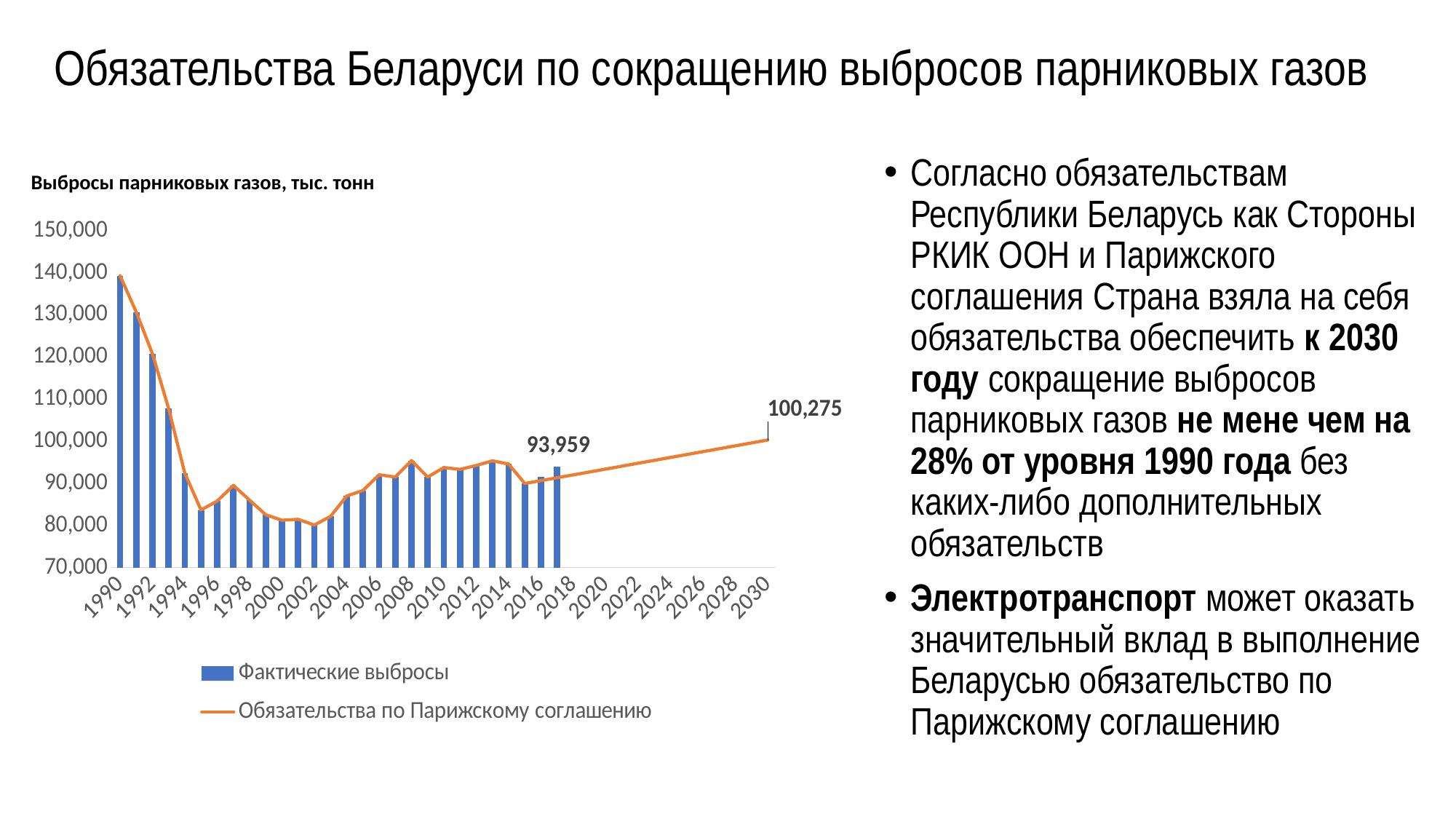
Do the actual emissions values rise or fall from 1990 to 1995? fall What value is labelled on the chart at 2018? 93,959 What is the difference between the 2030 labelled value (100,275) and the 2018 labelled value (93,959)? 6,316 Which year has the highest actual emissions bar? 1990 Is the actual emissions value for 1990 greater or less than 130,000? greater Is the actual emissions value for 2008 greater or less than 90,000? greater What kind of chart is shown on the slide? A combined bar and line chart Is the actual emissions value for 2002 greater or less than 90,000? less How many series does the chart legend list? 2 What value is labelled for the Paris agreement obligation line in 2030? 100,275 Which year has the larger actual emissions bar, 1994 or 1996? 1994 What is the title of the chart? Выбросы парниковых газов, тыс. тонн